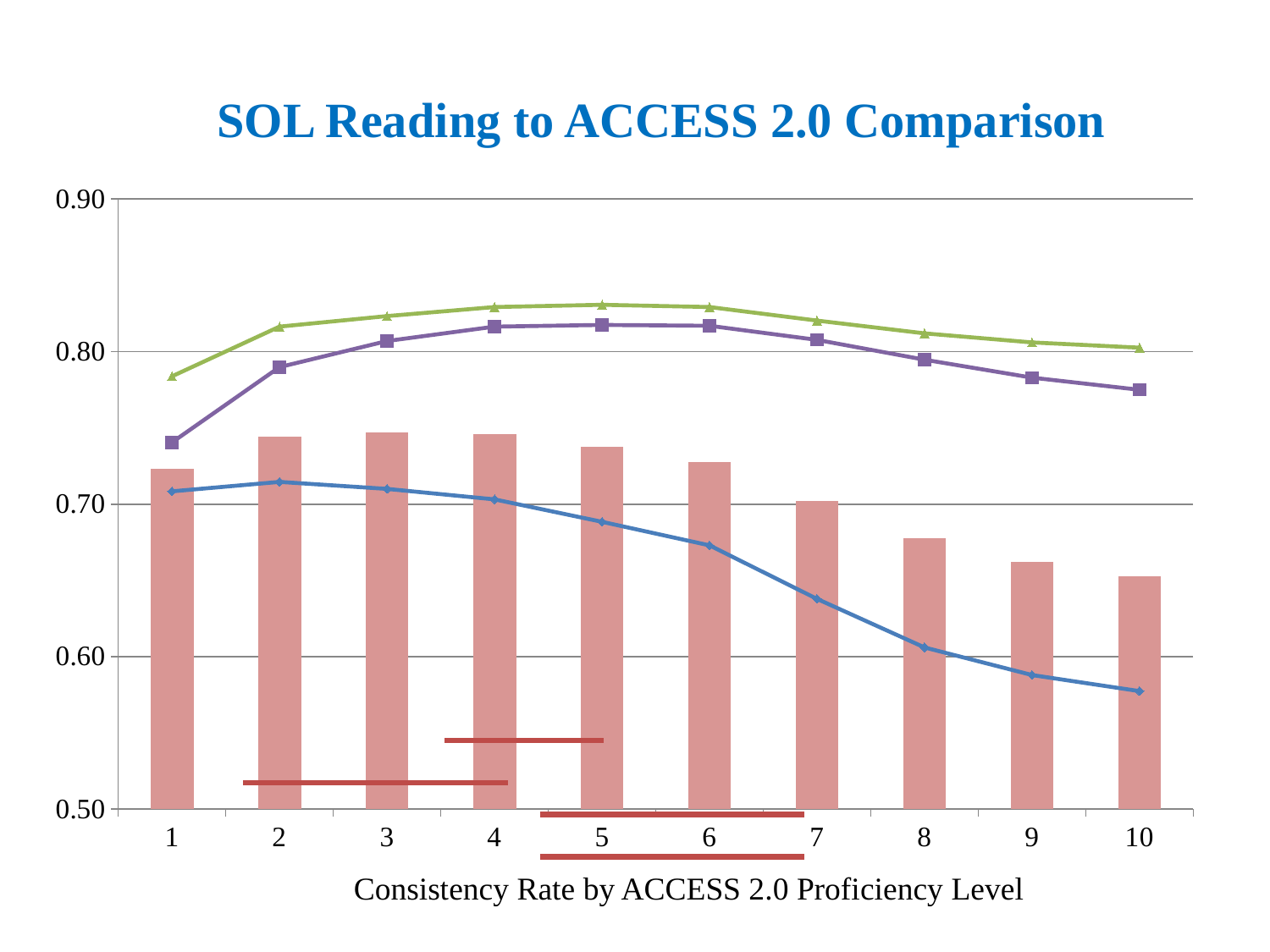
What kind of chart is shown on the slide? A combination bar and line chart Is the value of the purple line at proficiency level 1 greater or less than 0.80? less Does the blue line rise or fall from proficiency level 2 to proficiency level 10? Fall What is the x-axis label of the chart? Consistency Rate by ACCESS 2.0 Proficiency Level Is the value of the green line at proficiency level 5 greater or less than 0.80? greater How many proficiency levels are shown along the x axis? 10 What is the title of the chart? SOL Reading to ACCESS 2.0 Comparison Is the value of the bar at proficiency level 1 greater or less than 0.70? greater Which is larger, the bar at proficiency level 2 or the bar at proficiency level 8? Level 2 At which proficiency level does the blue line reach its lowest value? 10